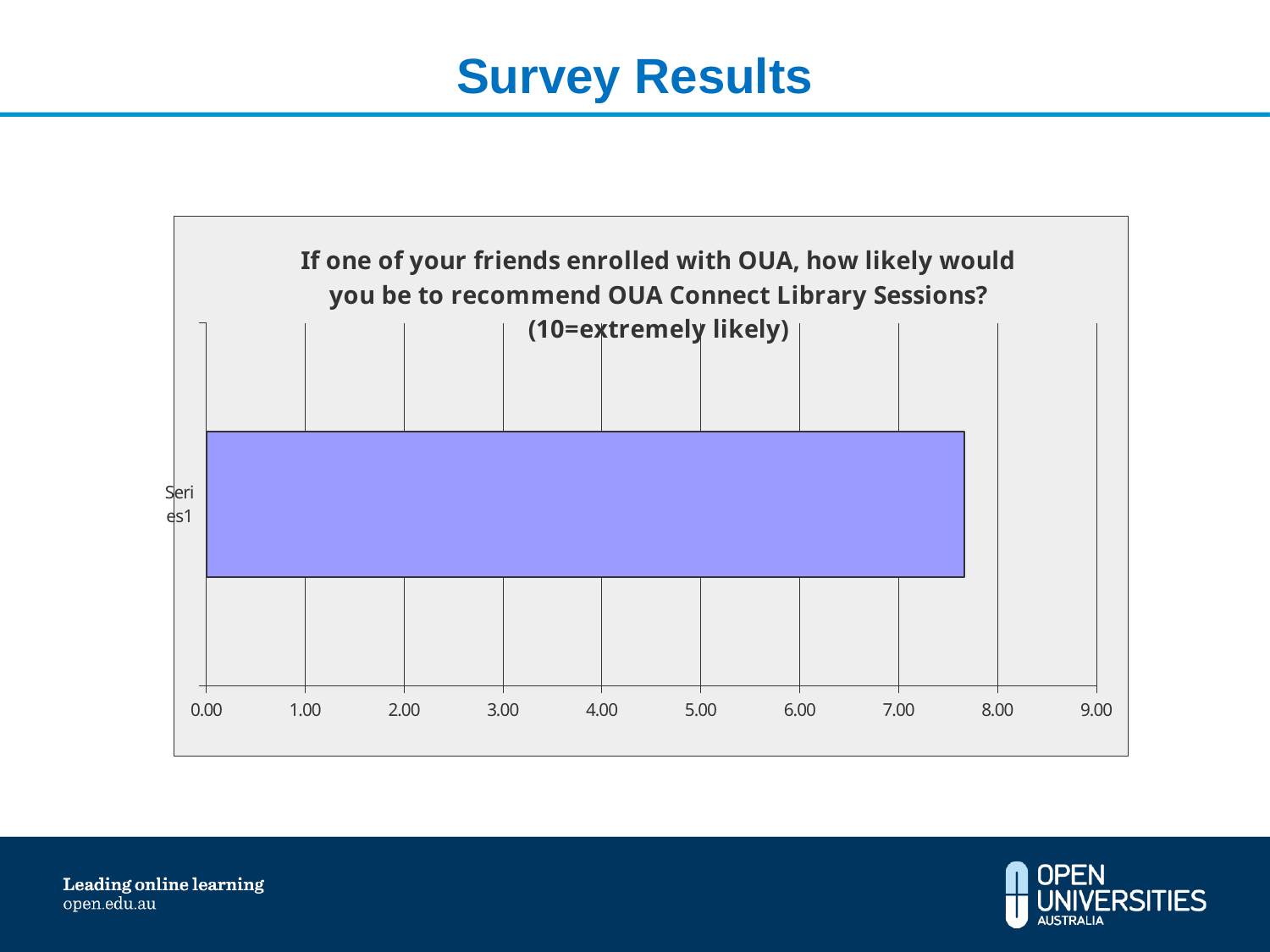
What is the highest value shown on the horizontal axis? 9.00 What colour is the bar in the chart? light purple Is the value for Series1 greater or less than 7.00? greater Is the value for Series1 greater or less than 8.00? less Is the value for Series1 greater or less than 5.00? greater What kind of chart is shown on the slide? bar chart How many bars are plotted in the chart? 1 What is the label of the single category on the vertical axis? Series1